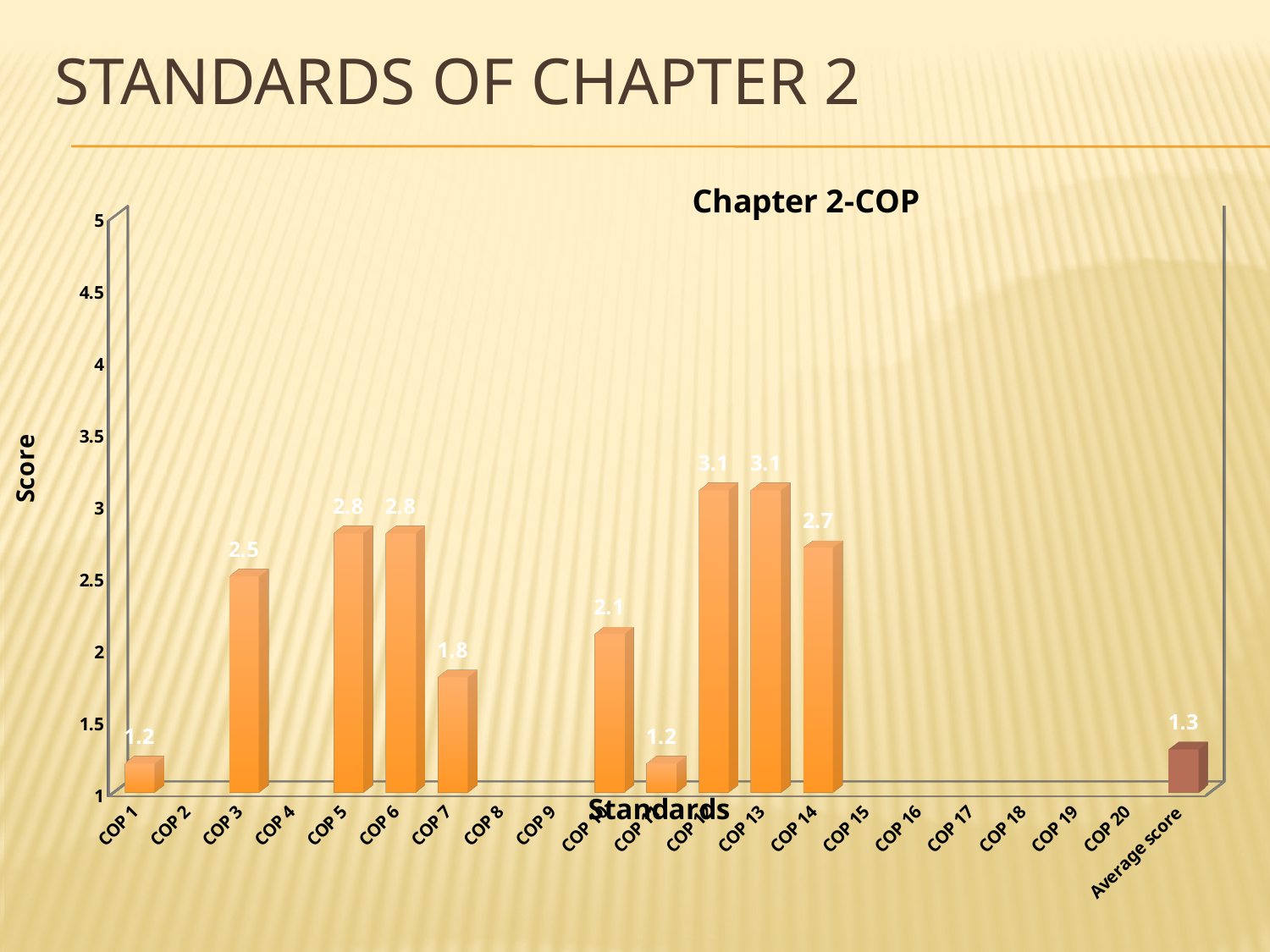
What is the difference between the scores for COP 12 and COP 14? 0.4 What is the title of the chart? Chapter 2-COP What is the score for COP 7? 1.8 How many categories are shown on the x axis? 21 Which has a higher score, COP 5 or COP 7? COP 5 What kind of chart is shown on the slide? bar chart What is the score for COP 14? 2.7 What is the score for COP 6? 2.8 What is the score for COP 3? 2.5 What is the value shown for Average score? 1.3 What is the difference between the scores for COP 3 and COP 1? 1.3 Is the score for COP 13 greater or less than 3? greater